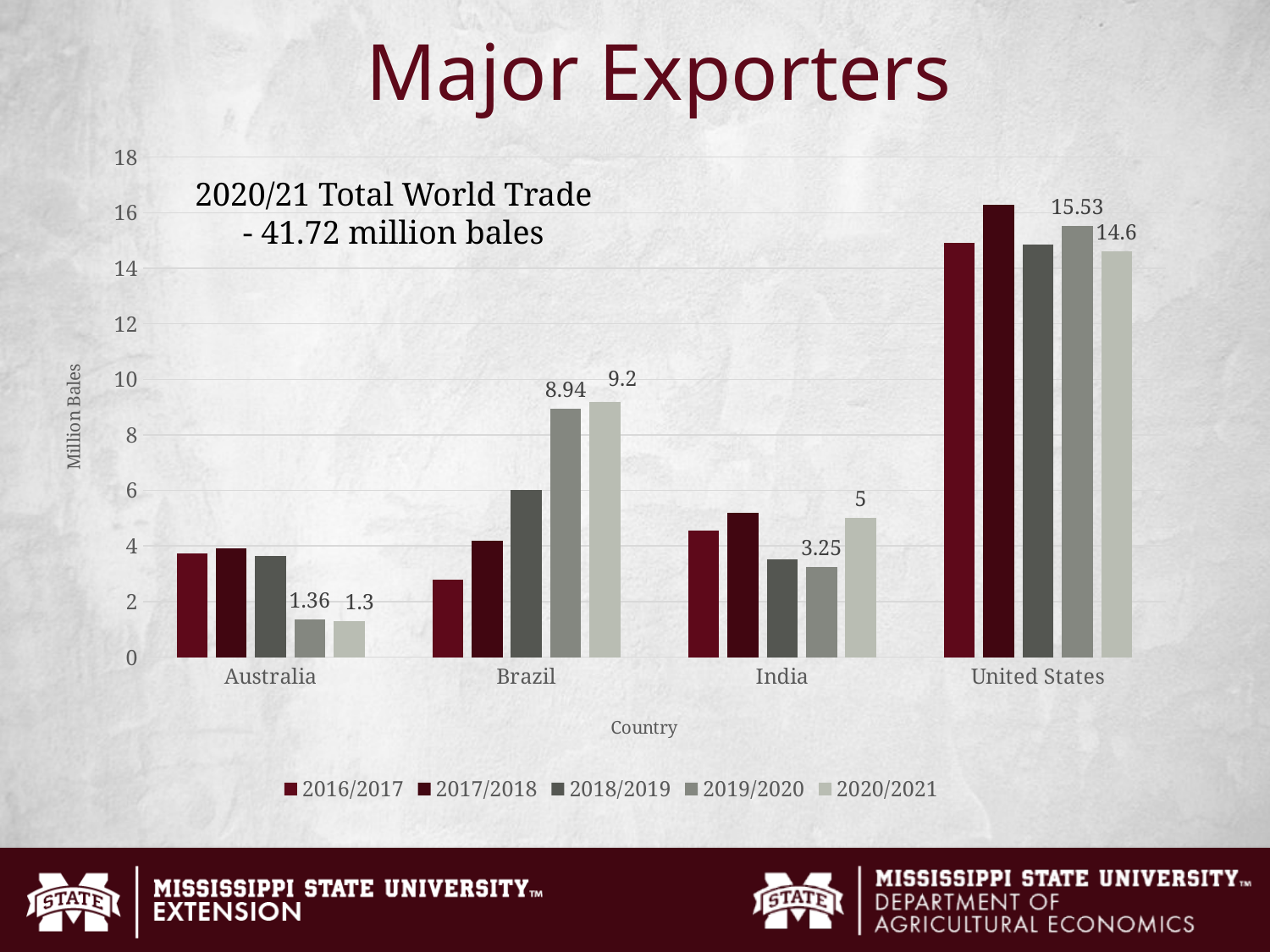
Which is larger for the United States, the 2019/2020 value or the 2020/2021 value? 2019/2020 What is the difference between the 2019/2020 and 2020/2021 values for India? 1.75 Which country has the highest 2020/2021 value? United States What is the 2020/2021 value for Brazil? 9.2 Is the 2017/2018 value for the United States greater or less than 16? greater What is the 2019/2020 value for the United States? 15.53 Which country has the lowest 2020/2021 value? Australia What kind of chart is shown on the slide? Bar chart How many countries are shown on the x axis? 4 How many series does the legend list? 5 What is the 2019/2020 value for Australia? 1.36 What is the 2020/2021 value for India? 5